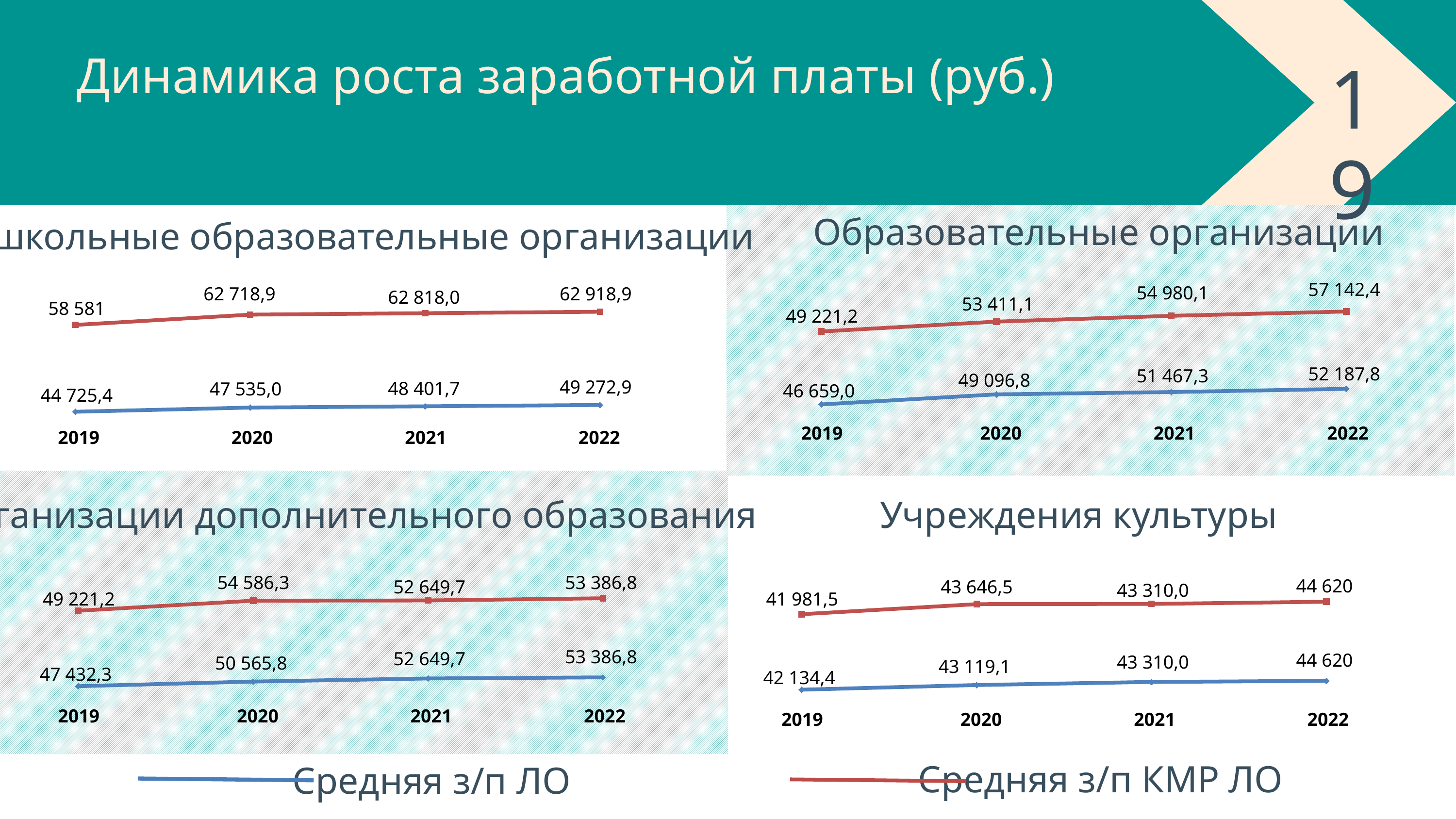
On the top-right chart titled 'Образовательные организации', what is the value of the red 'Средняя з/п КМР ЛО' line in 2022? 57 142,4 On the top-right chart titled 'Образовательные организации', what is the difference between the red and blue lines in 2019? 2 562,2 On the top-left chart, what is the value of the blue 'Средняя з/п ЛО' line in 2019? 44 725,4 On the bottom-right chart titled 'Учреждения культуры', which line is higher in 2019, the red 'Средняя з/п КМР ЛО' or the blue 'Средняя з/п ЛО'? Средняя з/п ЛО On the bottom-left chart, in which year is the red 'Средняя з/п КМР ЛО' line at its lowest? 2019 On the bottom-left chart, what is the value of the blue 'Средняя з/п ЛО' line in 2020? 50 565,8 How many years are shown on the x axis of the top-right chart titled 'Образовательные организации'? 4 What kind of chart is the bottom-right chart titled 'Учреждения культуры'? Line chart On the bottom-right chart titled 'Учреждения культуры', what is the value of the red 'Средняя з/п КМР ЛО' line in 2020? 43 646,5 On the top-right chart titled 'Образовательные организации', does the blue 'Средняя з/п ЛО' line rise or fall from 2019 to 2022? Rises On the top-left chart, in which year is the red 'Средняя з/п КМР ЛО' line at its highest? 2022 How many series does the legend at the bottom of the slide list? 2